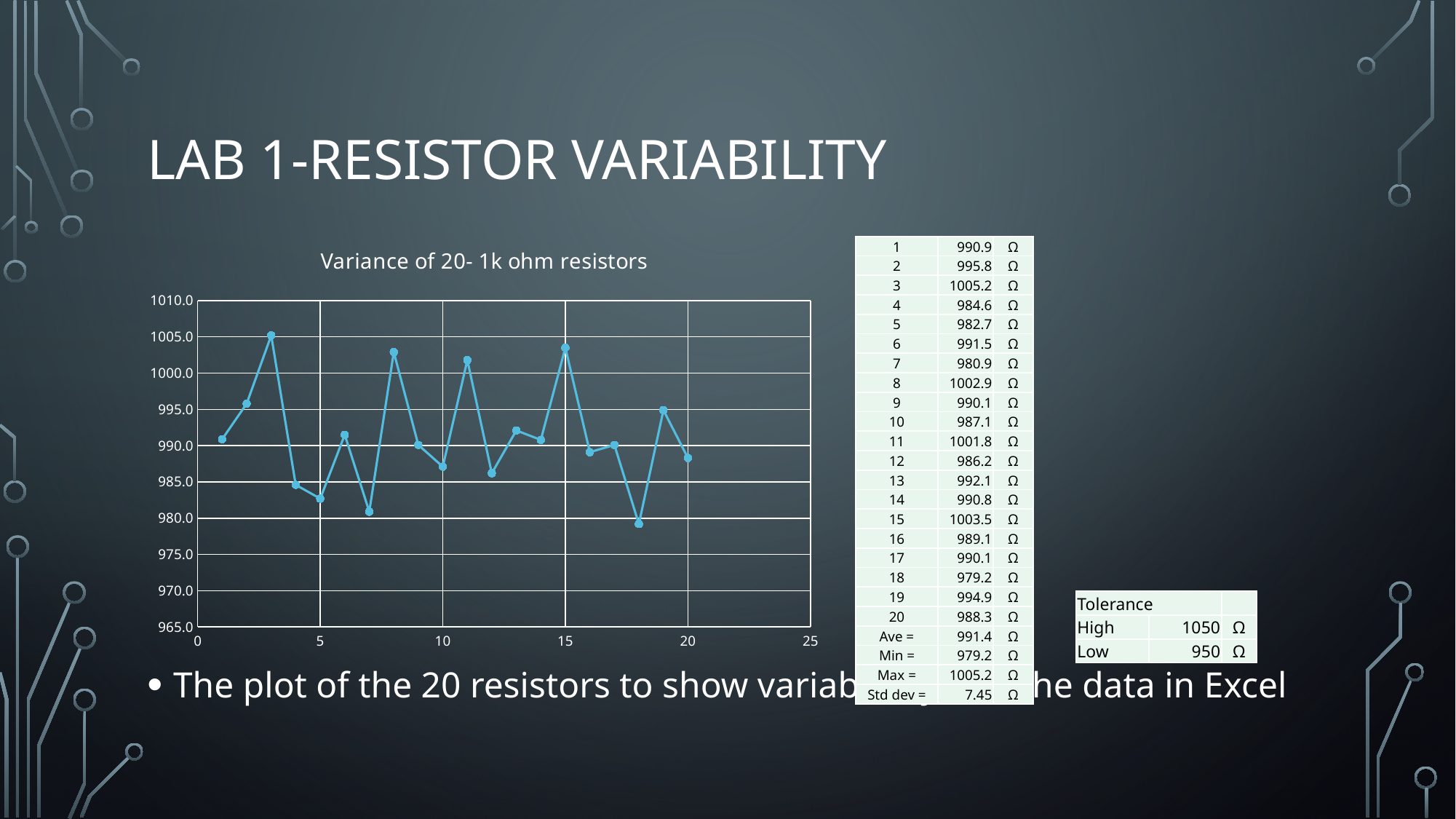
Is the value for resistor 18 greater or less than 980.0? less Which has the larger value, resistor 3 or resistor 18? resistor 3 Is the value for resistor 3 greater or less than 1000.0? greater Which resistor number has the highest plotted value? 3 Is the value for resistor 8 greater or less than 1000.0? greater Which resistor number has the lowest plotted value? 18 What kind of chart is shown on the slide? line chart What is the title of the chart? Variance of 20- 1k ohm resistors What is the difference between the maximum and minimum resistor values listed on the slide? 26.0 Ω How many data points are plotted on the chart? 20 What is the value for resistor 15 as listed in the table on the slide? 1003.5 Ω